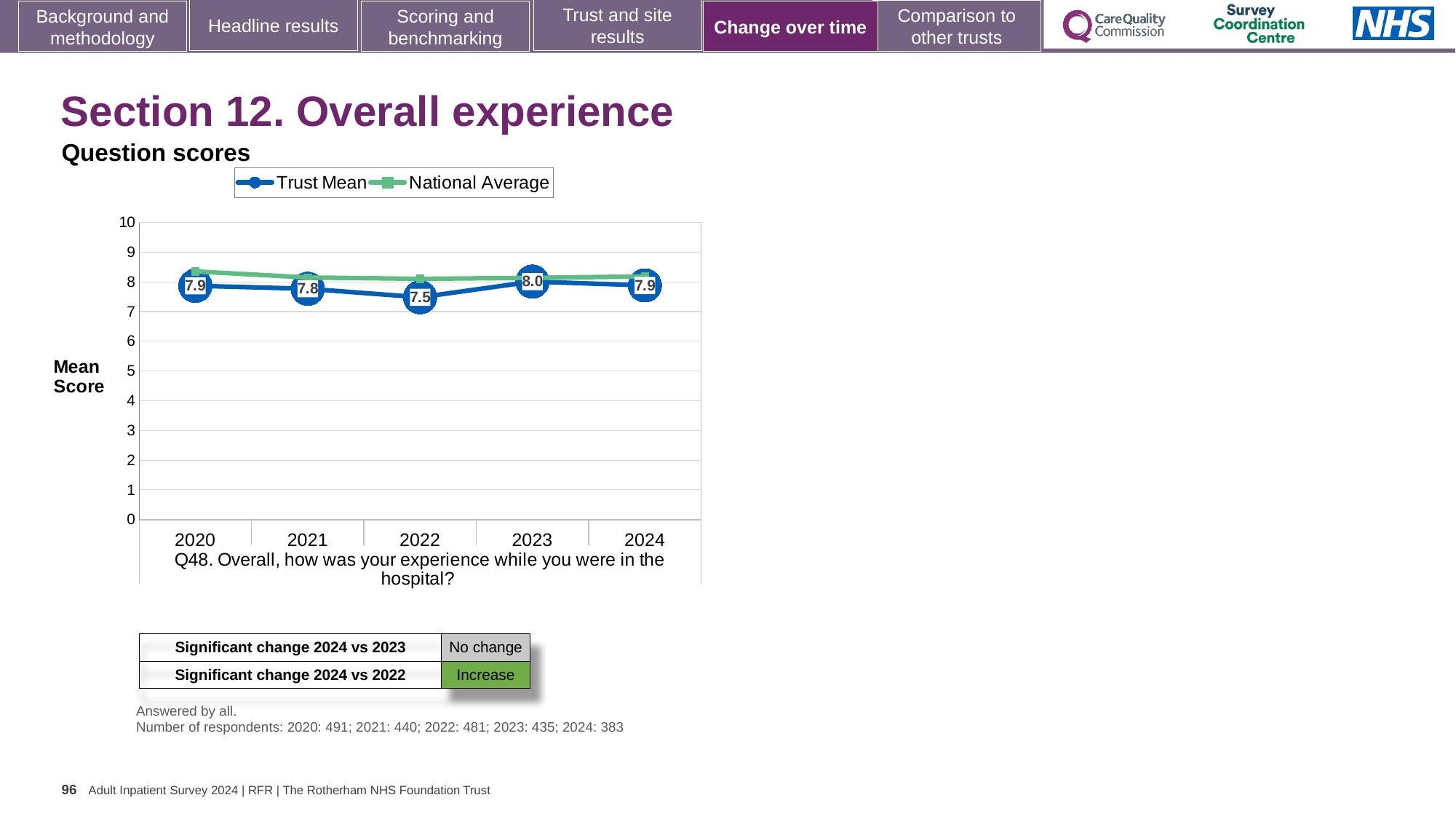
What is the Trust Mean score for 2023? 8.0 How many years are shown on the x axis of the chart? 5 In which year is the Trust Mean score lowest? 2022 What is the Trust Mean score for 2020? 7.9 What is the difference between the Trust Mean scores for 2023 and 2022? 0.5 In which year is the Trust Mean score highest? 2023 Which year has the larger Trust Mean score, 2021 or 2023? 2023 Is the National Average value for 2020 greater or less than 8? greater Does the Trust Mean score rise or fall from 2022 to 2023? Rise What is the Trust Mean score for 2022? 7.5 What kind of chart is shown on the slide? Line chart How many series does the chart legend list? 2